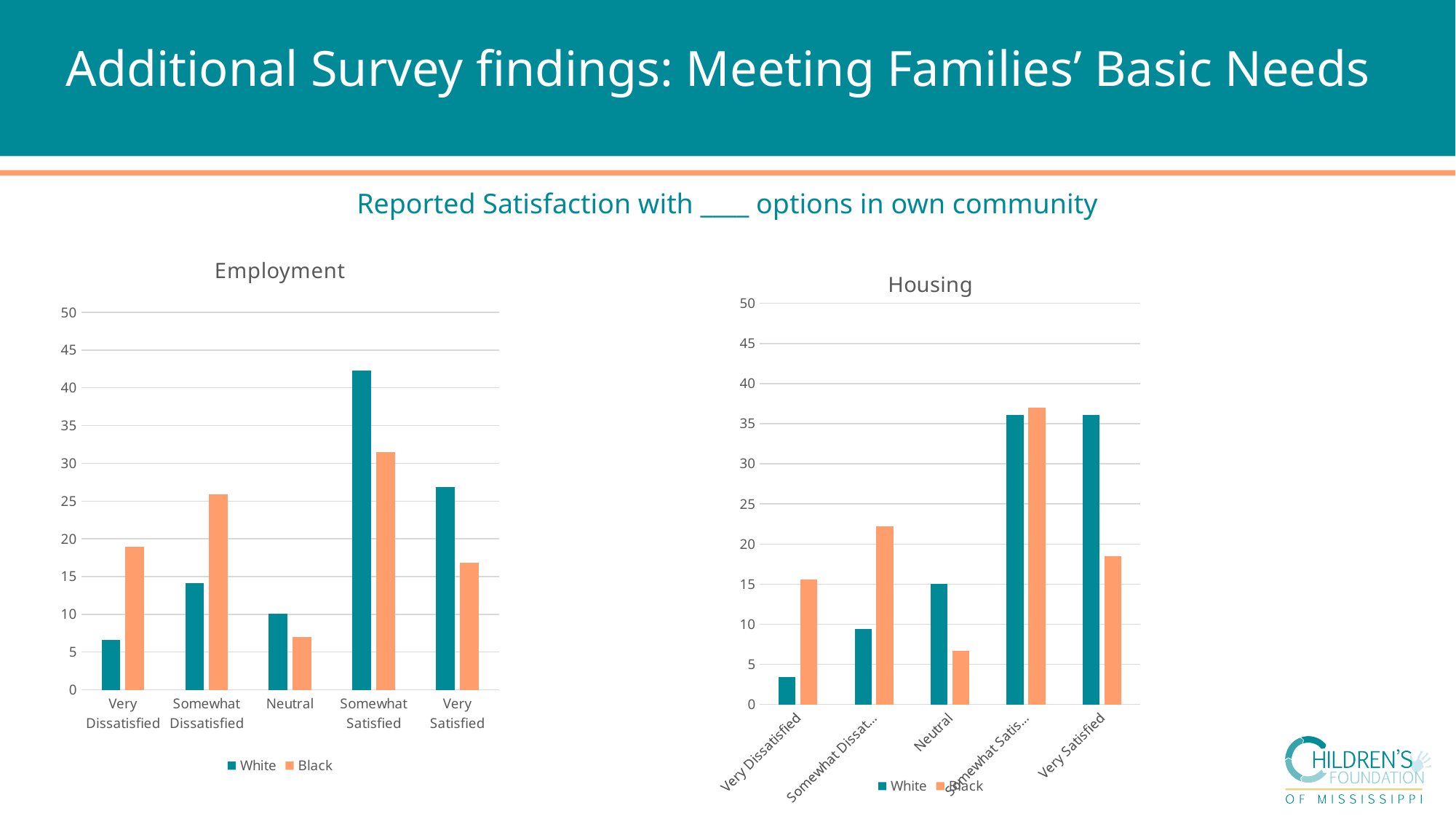
In the Housing chart, which category has the lowest value for White? Very Dissatisfied In the Employment chart, what kind of chart is shown? bar chart In the Employment chart, how many series does the legend list? 2 In the Employment chart, which category has the lowest value for Black? Neutral In the Housing chart, is the Black value for Somewhat Dissatisfied greater or less than 20? greater In the Employment chart, is the White value for Somewhat Satisfied greater or less than 40? greater In the Housing chart, for Very Satisfied, which series has the larger value, White or Black? White In the Employment chart, how many satisfaction categories are shown on the x axis? 5 What are the two legend entries in the Housing chart? White and Black In the Employment chart, for Very Dissatisfied, which series has the larger value, White or Black? Black In the Housing chart, is the White value for Very Dissatisfied greater or less than 5? less In the Employment chart, which category has the highest value for White? Somewhat Satisfied